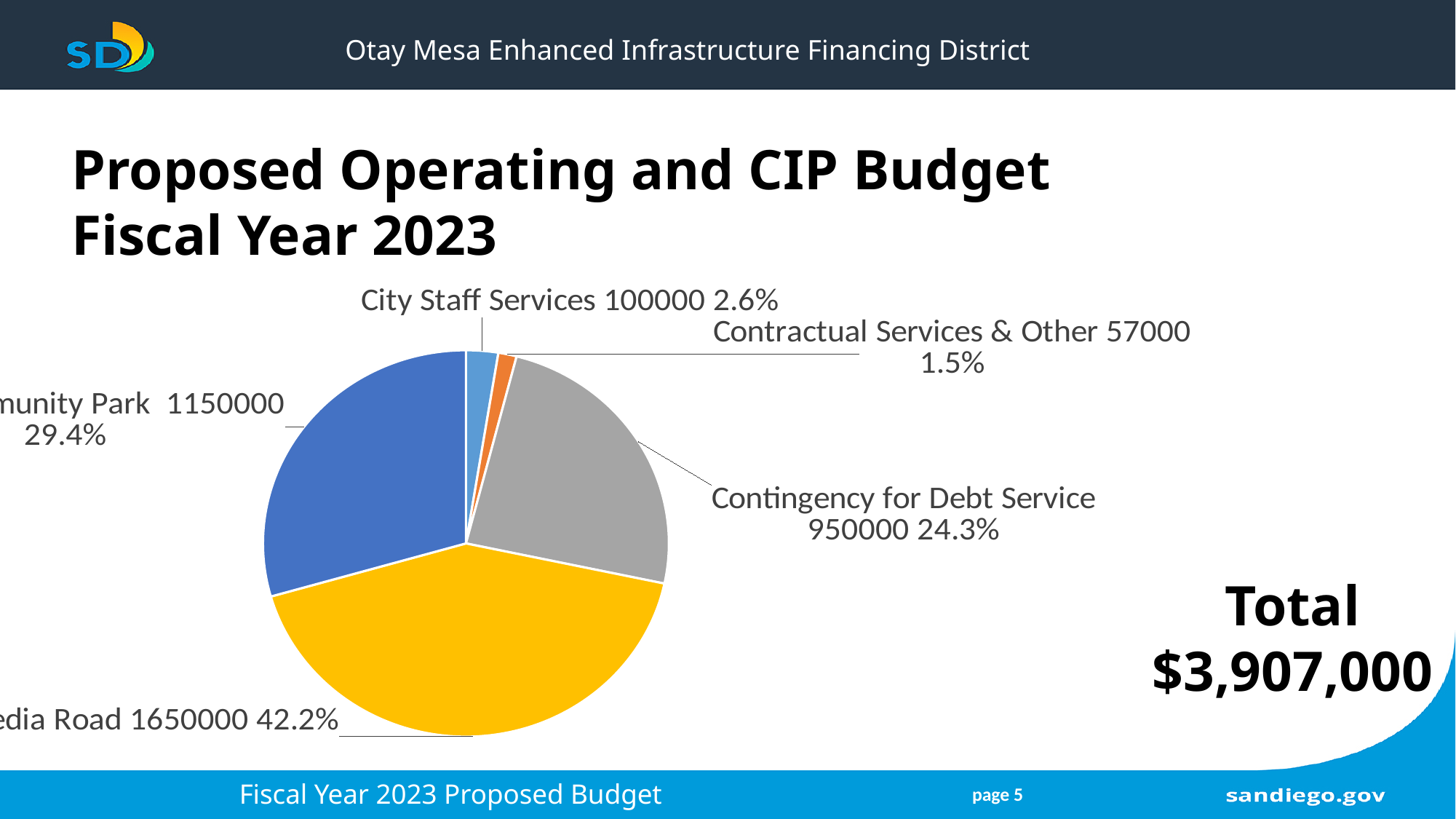
Which is larger, City Staff Services or Contractual Services & Other? City Staff Services What kind of chart is shown on the slide? pie chart What is the difference between the values for Contingency for Debt Service and City Staff Services? 850000 What share of the pie does City Staff Services represent? 2.6% What is the value shown for City Staff Services? 100000 What share of the pie does Contractual Services & Other represent? 1.5% How many slices does the pie chart have? 5 What is the difference between the values for City Staff Services and Contractual Services & Other? 43000 What is the value shown for Contractual Services & Other? 57000 What share of the pie does Contingency for Debt Service represent? 24.3% What is the value shown for Contingency for Debt Service? 950000 What total amount is printed next to the pie chart? $3,907,000